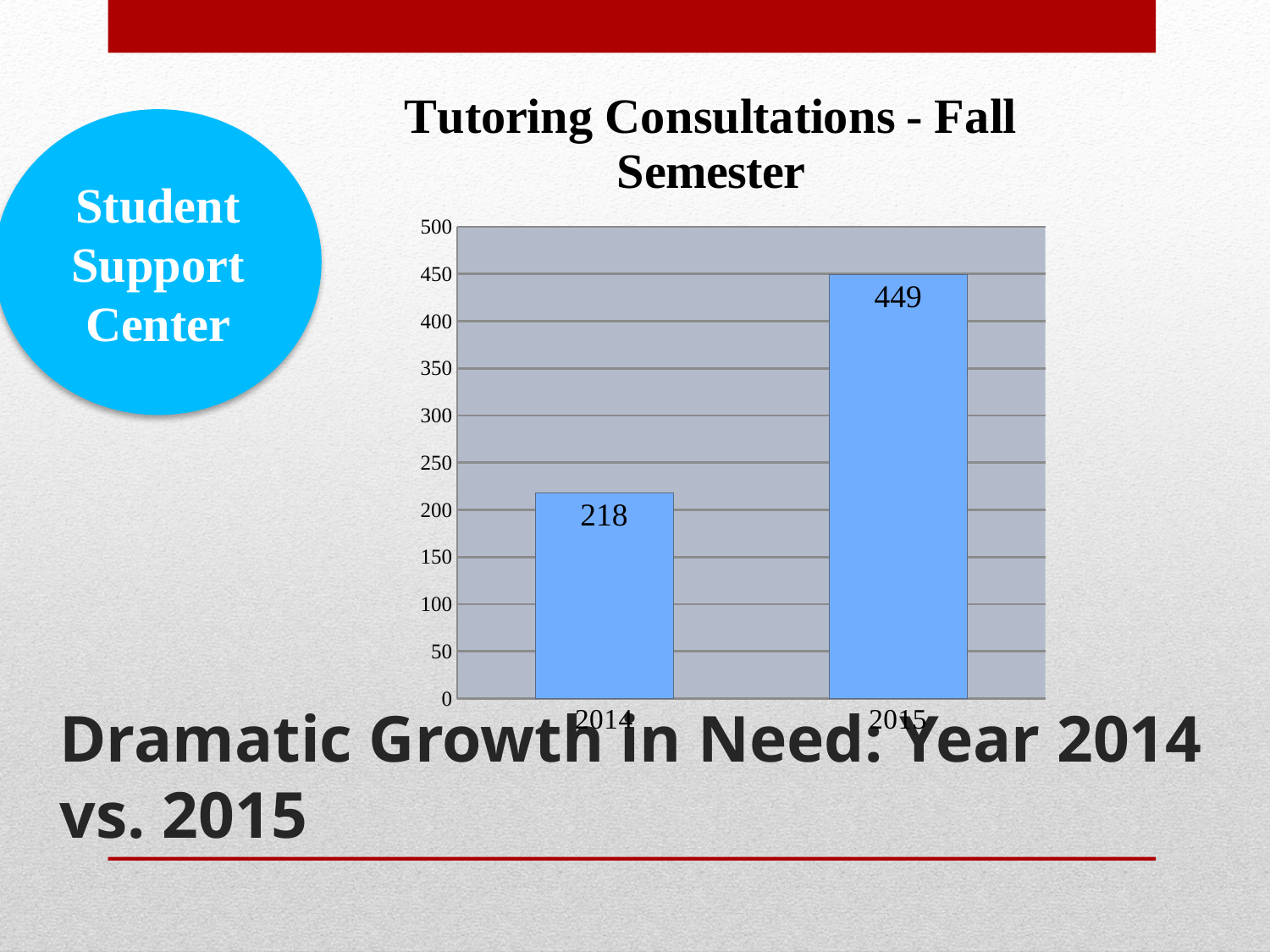
How many categories are shown on the x axis? 2 What is the value for 2014? 218 What kind of chart is shown on the slide? bar chart Which year has the highest number of tutoring consultations? 2015 What is the value for 2015? 449 Which year has the lowest number of tutoring consultations? 2014 Is the value for 2014 greater or less than 250? less Do the values rise or fall from 2014 to 2015? rise What is the difference between the values for 2015 and 2014? 231 Which is larger, the value for 2014 or the value for 2015? 2015 Is the value for 2015 greater or less than 400? greater What is the title of the chart? Tutoring Consultations - Fall Semester